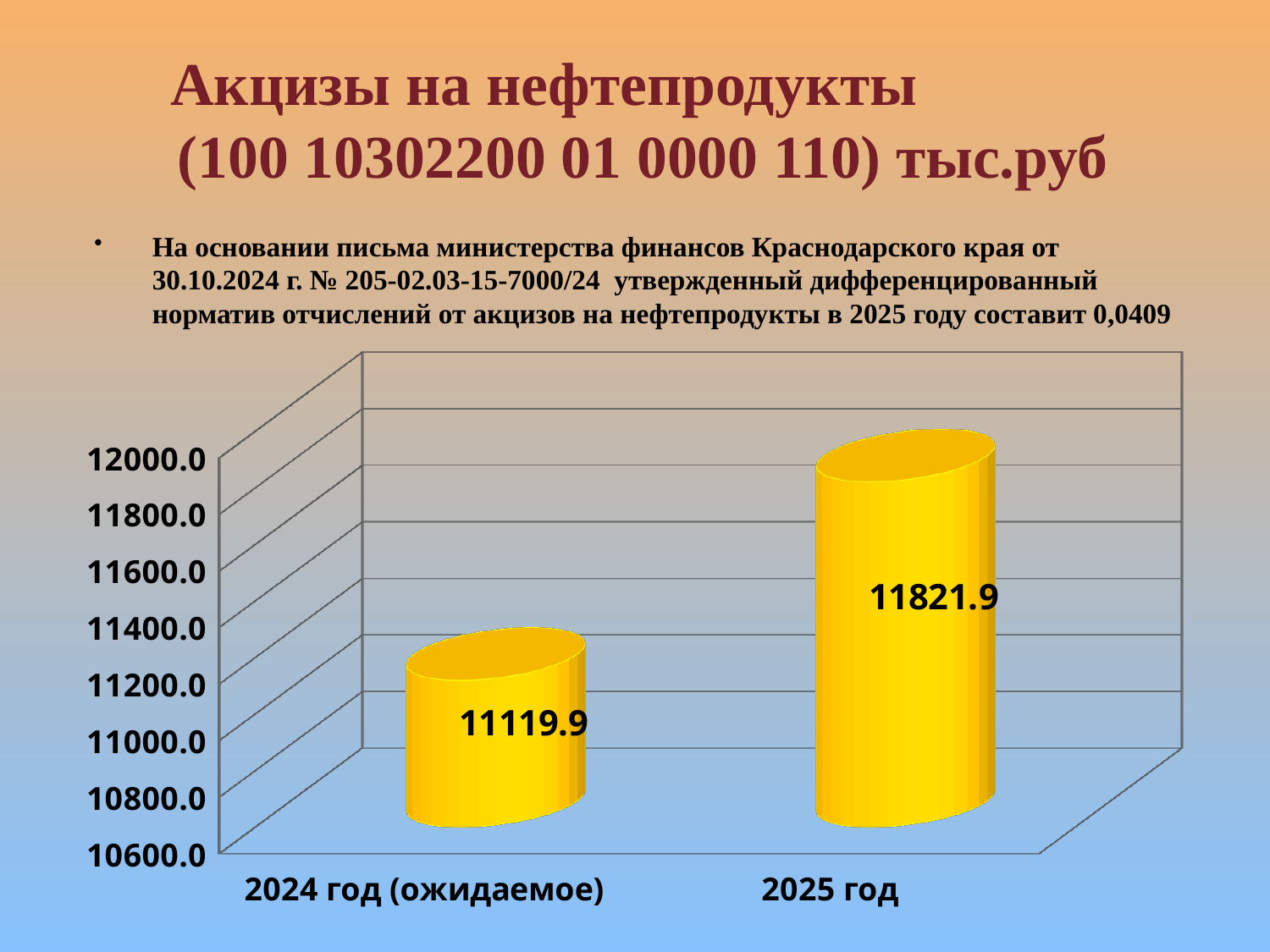
Which is larger: the value for 2024 год (ожидаемое) or the value for 2025 год? 2025 год What is the value for 2024 год (ожидаемое)? 11119.9 Which category has the highest value? 2025 год What is the lowest value shown on the vertical axis? 10600.0 What is the difference between the values for 2025 год and 2024 год (ожидаемое)? 702.0 How many categories are shown on the x axis? 2 Is the value for 2024 год (ожидаемое) greater or less than 11200.0? less Is the value for 2025 год greater or less than 11600.0? greater What is the value for 2025 год? 11821.9 Which category has the lowest value? 2024 год (ожидаемое) Do the values rise or fall from 2024 год (ожидаемое) to 2025 год? rise What kind of chart is shown on the slide? bar chart